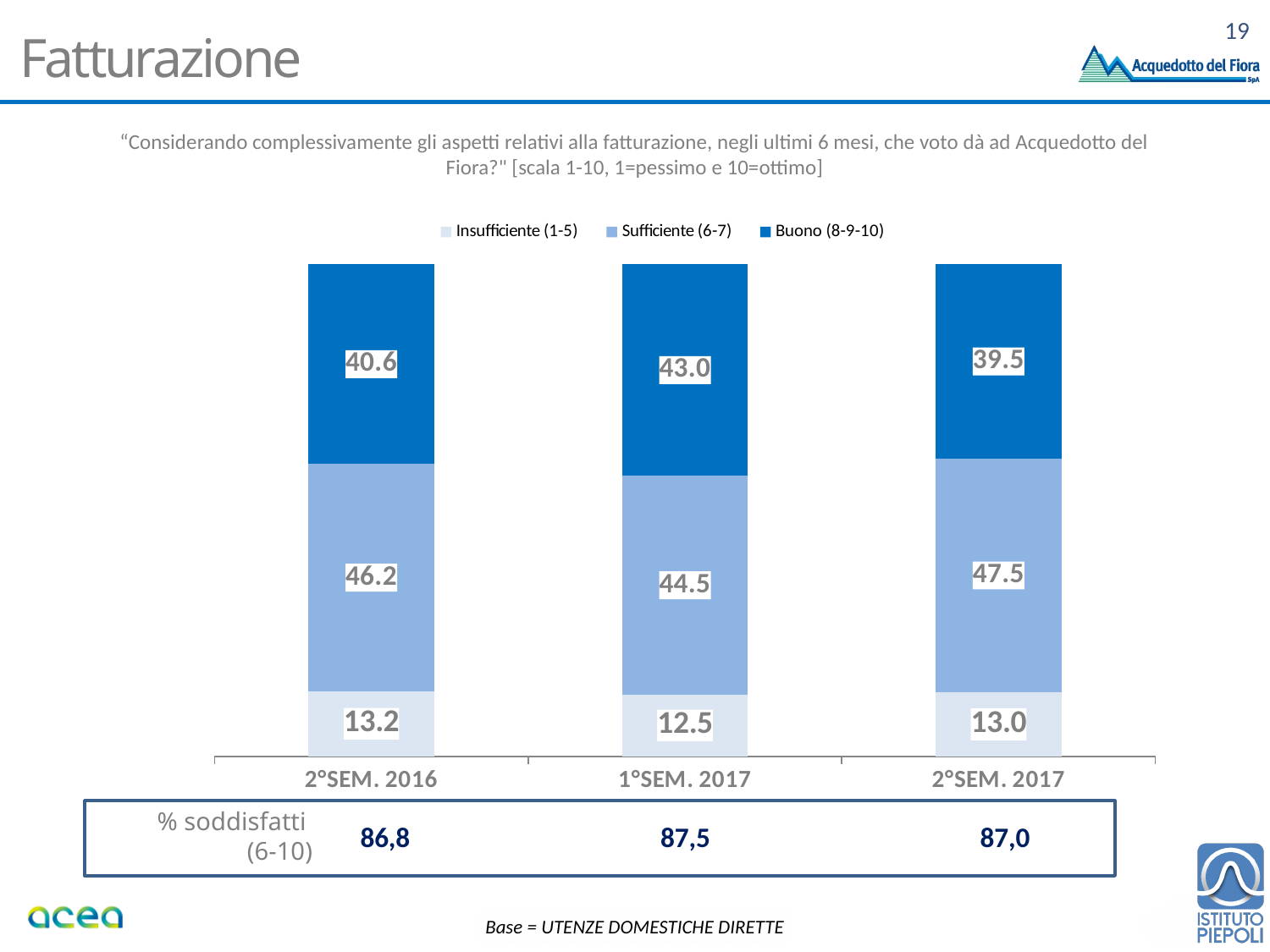
What is the % soddisfatti (6-10) value shown for 2°SEM. 2017? 87,0 In which period is the Insufficiente (1-5) value lowest? 1°SEM. 2017 What is the value for Buono (8-9-10) in 1°SEM. 2017? 43.0 What is the difference between the Sufficiente (6-7) values for 2°SEM. 2017 and 1°SEM. 2017? 3.0 What is the value for Insufficiente (1-5) in 2°SEM. 2016? 13.2 What is the total of the stacked bar for 1°SEM. 2017? 100.0 What is the value for Sufficiente (6-7) in 2°SEM. 2017? 47.5 What kind of chart is shown on the slide? Stacked bar chart Which is larger in 2°SEM. 2016: the Sufficiente (6-7) value or the Buono (8-9-10) value? Sufficiente (6-7) In which period is the Buono (8-9-10) value highest? 1°SEM. 2017 How many periods are shown on the x axis of the chart? 3 How many series does the legend list? 3